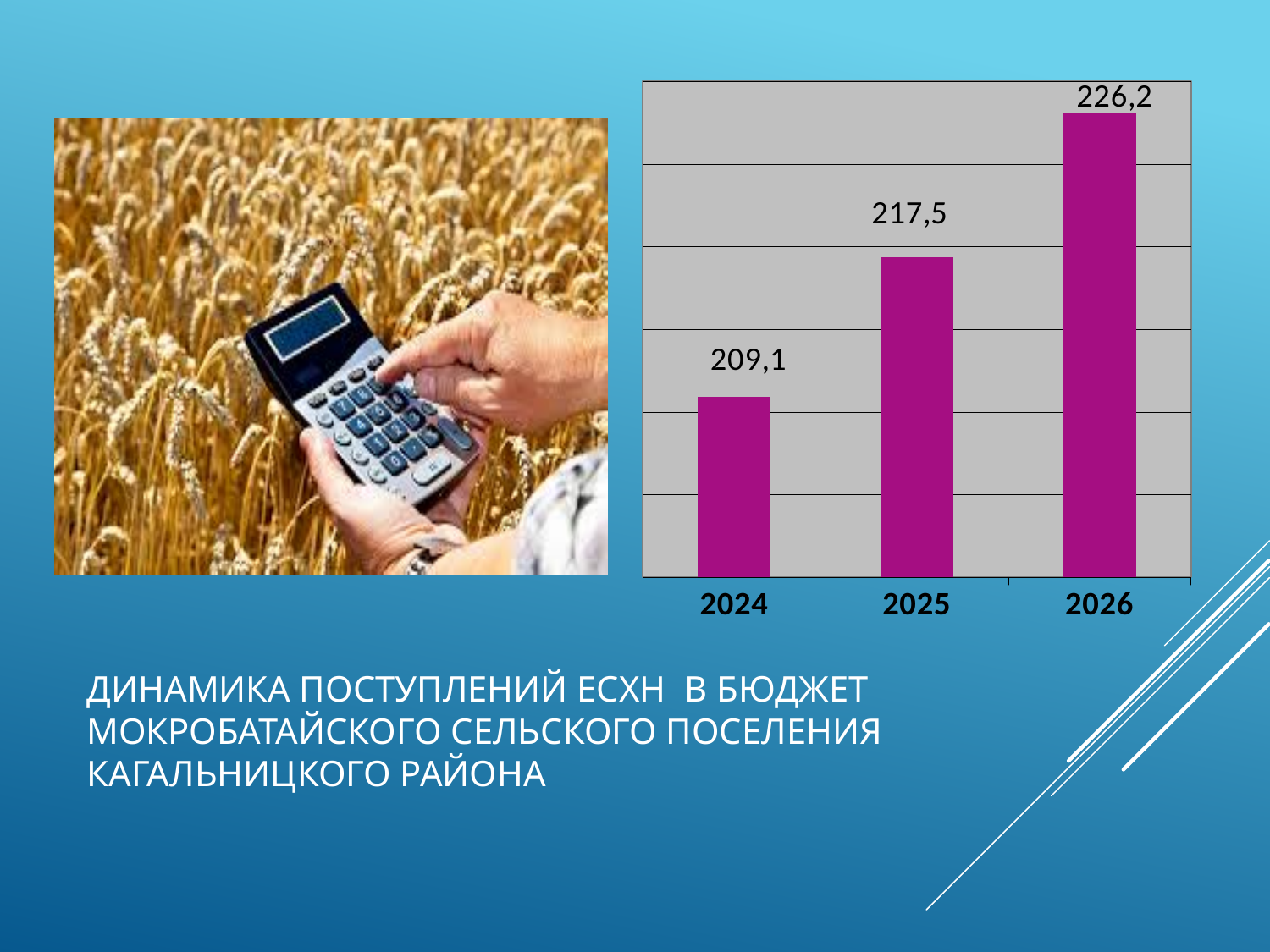
Which year has the highest value? 2026 What kind of chart is shown on the slide? Bar chart What is the difference between the values for 2026 and 2025? 8,7 What is the value shown for 2025? 217,5 What is the value shown for 2024? 209,1 How many years are shown on the chart? 3 Which year has the lowest value? 2024 Which is larger, the value for 2025 or the value for 2026? 2026 What is the value shown for 2026? 226,2 Do the values rise or fall from 2024 to 2026? Rise What is the difference between the values for 2026 and 2024? 17,1 What is the difference between the values for 2025 and 2024? 8,4